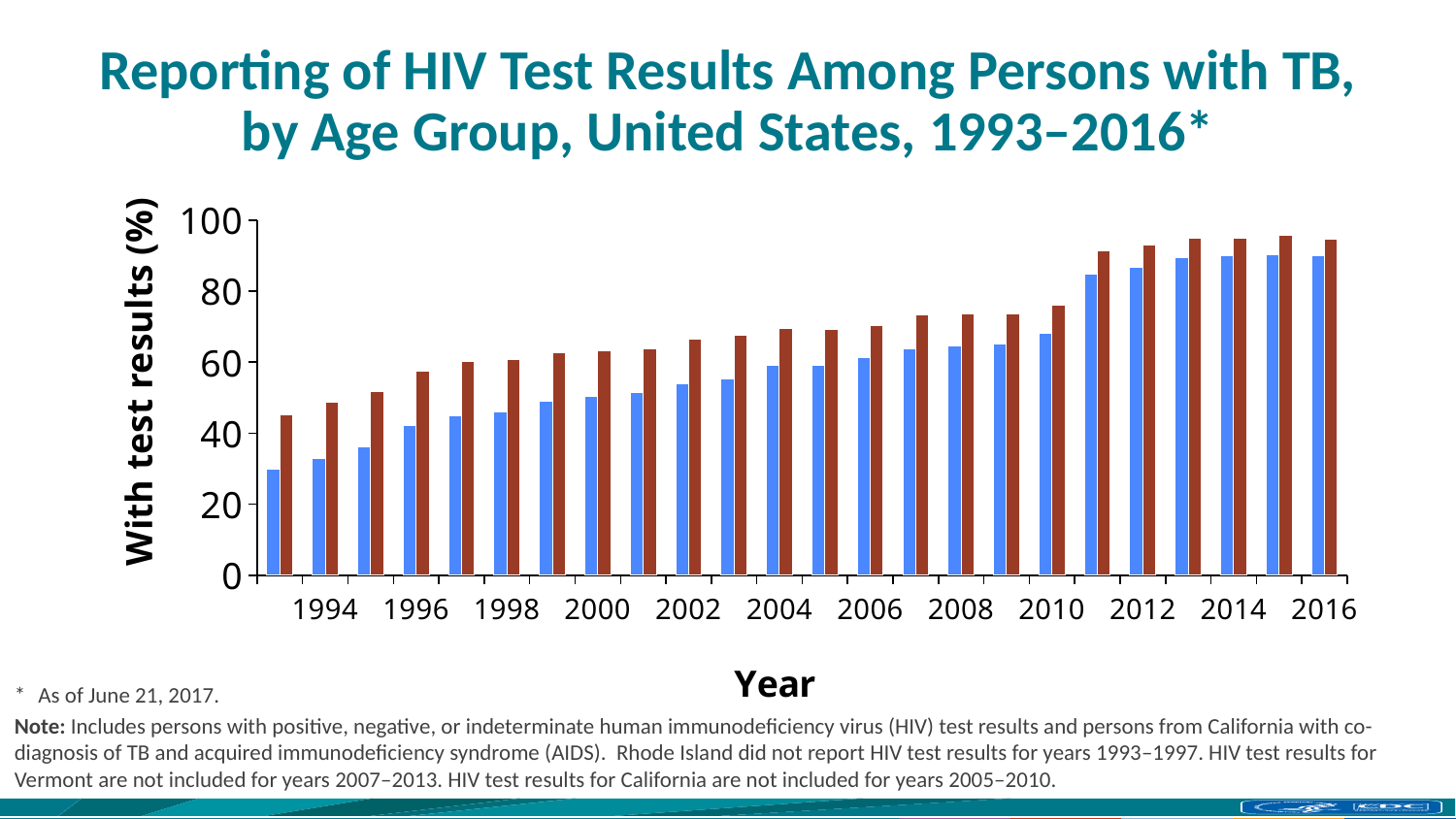
Is the value of the brown bar for 2016 greater or less than 80? greater Is the value of the blue bar for 2010 greater or less than 60? greater In 1993, which bar is taller, the blue bar or the brown bar? the brown bar What kind of chart is shown on the slide? bar chart Is the value of the brown bar for 1994 greater or less than 60? less What is the label of the x axis of the chart? Year Do the values of the brown bars generally rise or fall from 1993 to 2016? rise What is the label of the y axis of the chart? With test results (%) How many years (category groups) are plotted on the x axis of the chart? 24